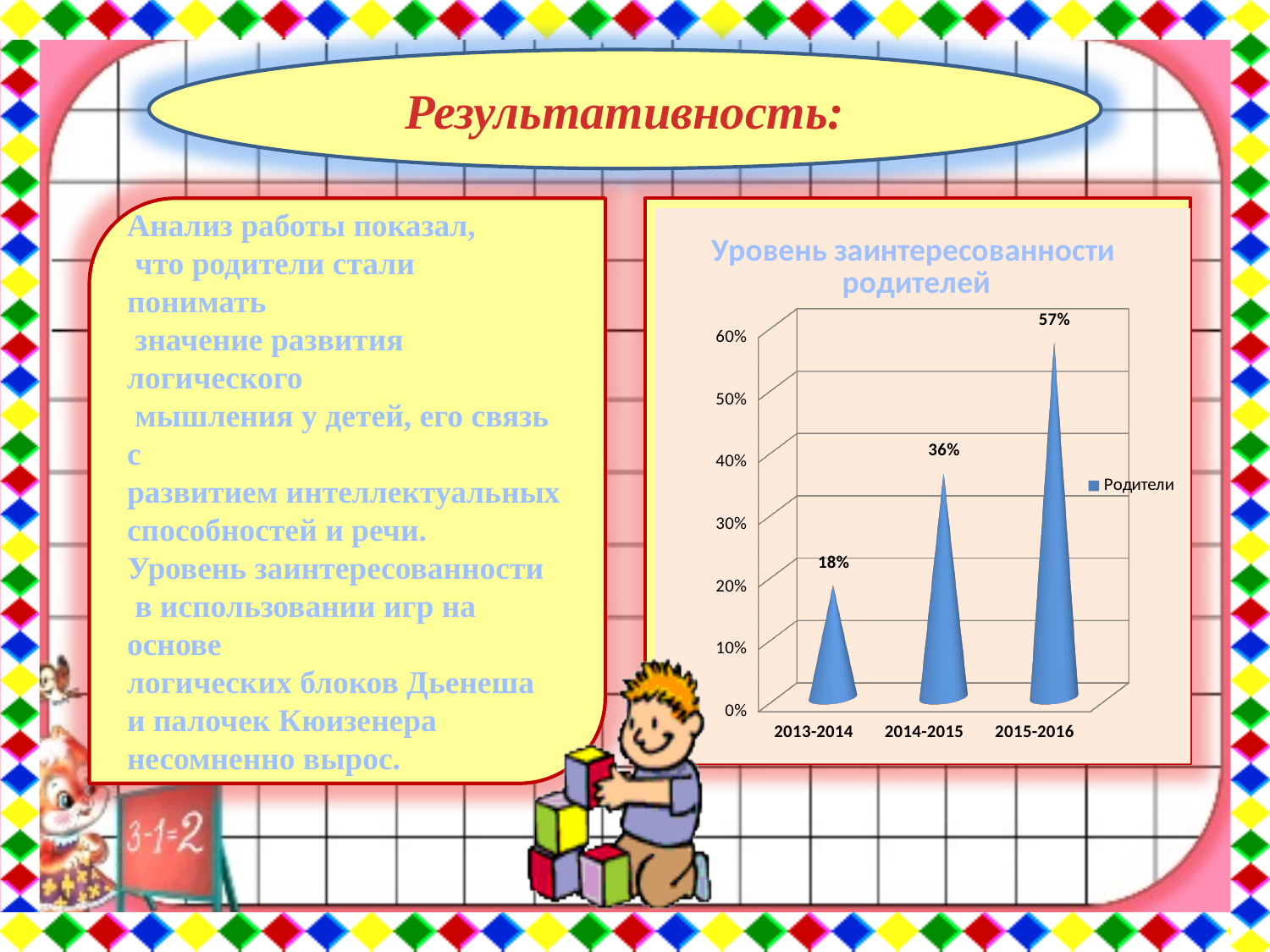
Which period has the highest value? 2015-2016 Which is larger, the value for 2014-2015 or the value for 2013-2014? 2014-2015 Is the value for 2015-2016 greater or less than 50%? greater What is the value for 2015-2016? 57% What is the value for 2013-2014? 18% Which period has the lowest value? 2013-2014 How many periods are shown on the x axis? 3 How many series does the legend list? 1 What is the value for 2014-2015? 36% What is the difference between the values for 2015-2016 and 2013-2014? 39% What is the difference between the values for 2014-2015 and 2013-2014? 18% Do the values rise or fall from 2013-2014 to 2015-2016? rise